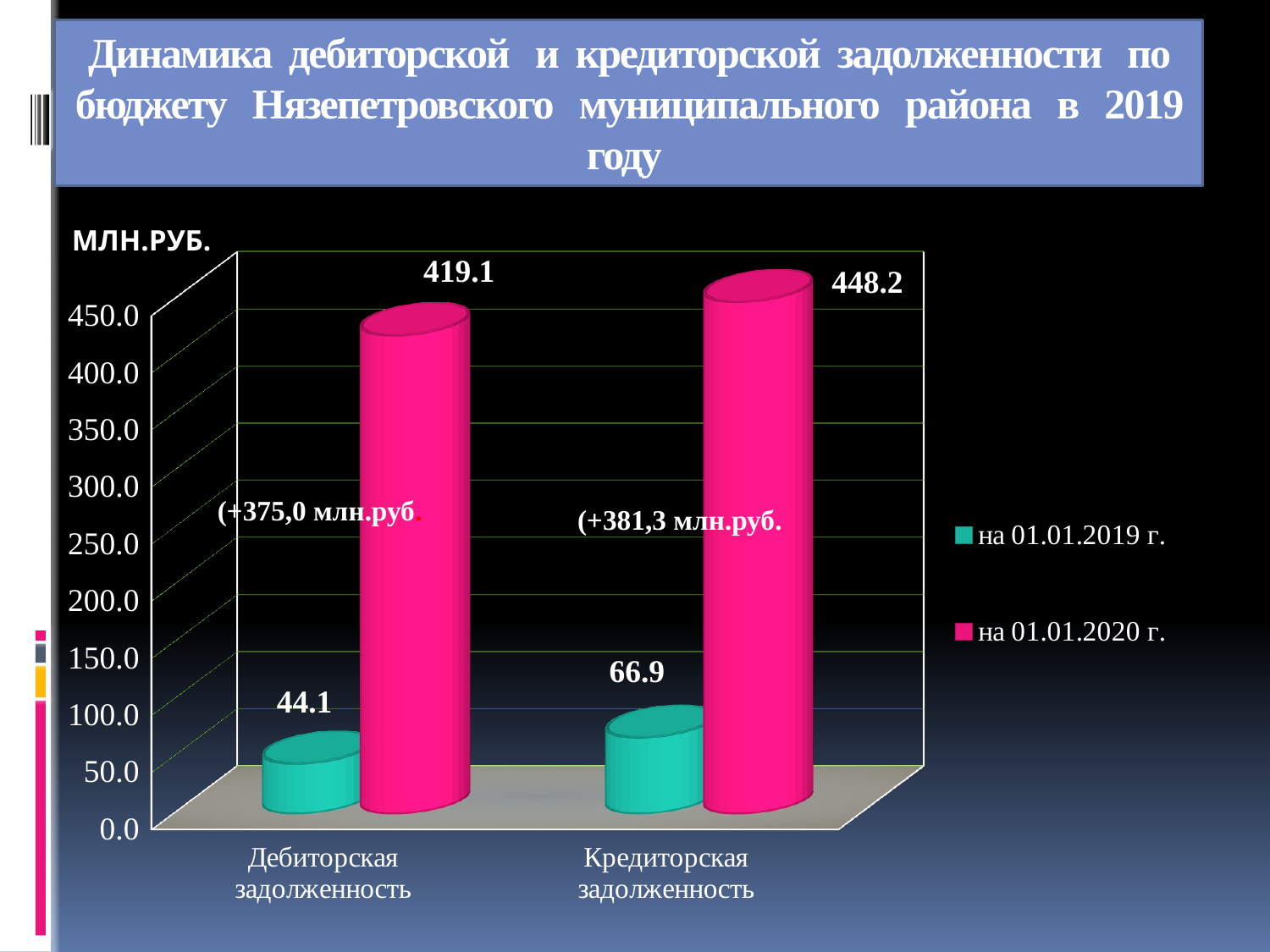
Is the на 01.01.2020 г. value for Дебиторская задолженность greater or less than 400.0? greater What kind of chart is shown on the slide? bar chart What is the value for Дебиторская задолженность in the series на 01.01.2020 г.? 419.1 How many series does the legend list? 2 Which category has the lowest value in the series на 01.01.2019 г.? Дебиторская задолженность Which is larger: the на 01.01.2019 г. value for Дебиторская задолженность or for Кредиторская задолженность? Кредиторская задолженность Which category has the highest value in the series на 01.01.2020 г.? Кредиторская задолженность How many categories are shown on the x axis? 2 What is the value for Кредиторская задолженность in the series на 01.01.2020 г.? 448.2 What is the value for Кредиторская задолженность in the series на 01.01.2019 г.? 66.9 What is the difference between the на 01.01.2020 г. and на 01.01.2019 г. values for Кредиторская задолженность? 381.3 What is the value for Дебиторская задолженность in the series на 01.01.2019 г.? 44.1